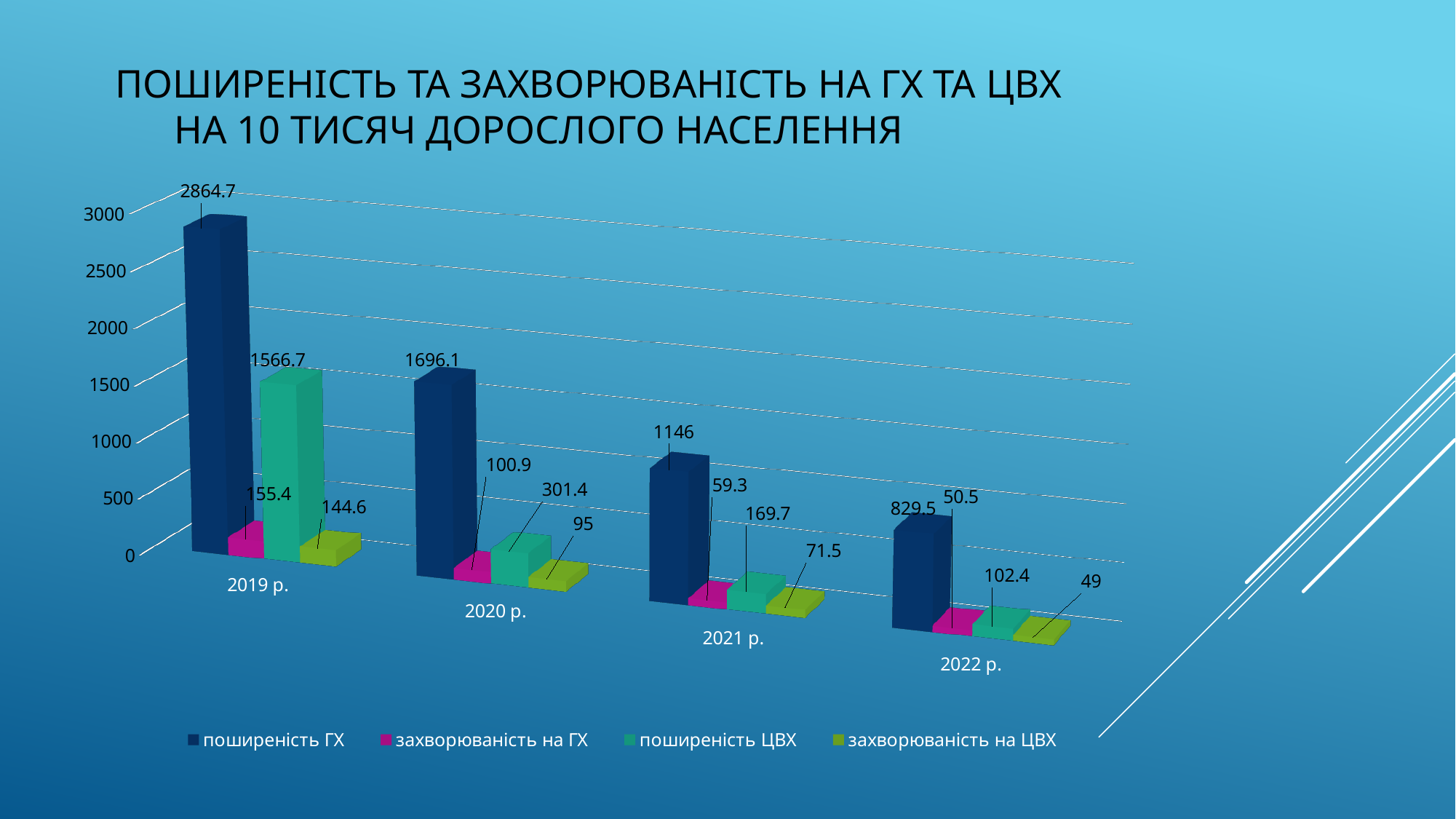
In which year is поширеність ЦВХ the lowest? 2022 р. What is the value of поширеність ЦВХ for 2020 р.? 301.4 What is the value of захворюваність на ГХ for 2021 р.? 59.3 What is the value of поширеність ГХ for 2019 р.? 2864.7 How many years are shown on the x axis? 4 Which is larger in 2021 р.: захворюваність на ГХ or захворюваність на ЦВХ? захворюваність на ЦВХ What is the difference between поширеність ГХ in 2019 р. and in 2020 р.? 1168.6 Does поширеність ГХ rise or fall from 2019 р. to 2022 р.? fall What kind of chart is shown on the slide? bar chart How many series does the legend list? 4 What is the value of захворюваність на ЦВХ for 2022 р.? 49 In which year is поширеність ГХ the highest? 2019 р.